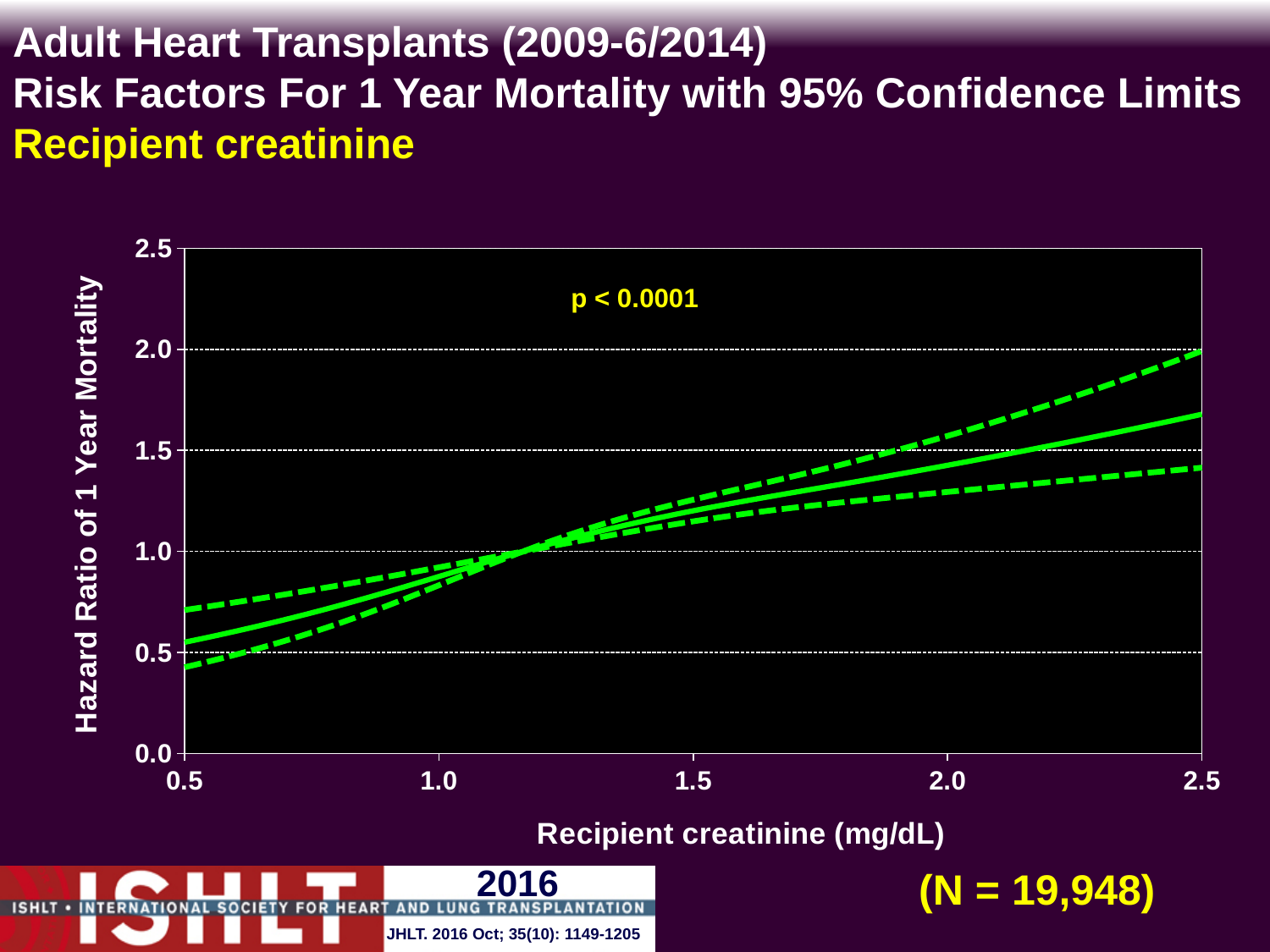
What is the sample size (N) shown on the slide? N = 19,948 Is the hazard ratio (solid line) at a recipient creatinine of 1.5 mg/dL greater or less than 1.0? greater Does the hazard ratio of 1 year mortality rise or fall as recipient creatinine increases from 0.5 to 2.5 mg/dL? rise Is the upper 95% confidence limit at a recipient creatinine of 2.5 mg/dL greater or less than 1.5? greater How many lines are plotted on the chart? 3 What kind of chart is shown on the slide? line chart Is the hazard ratio (solid line) at a recipient creatinine of 2.5 mg/dL greater or less than 1.5? greater What p-value is shown on the chart? p < 0.0001